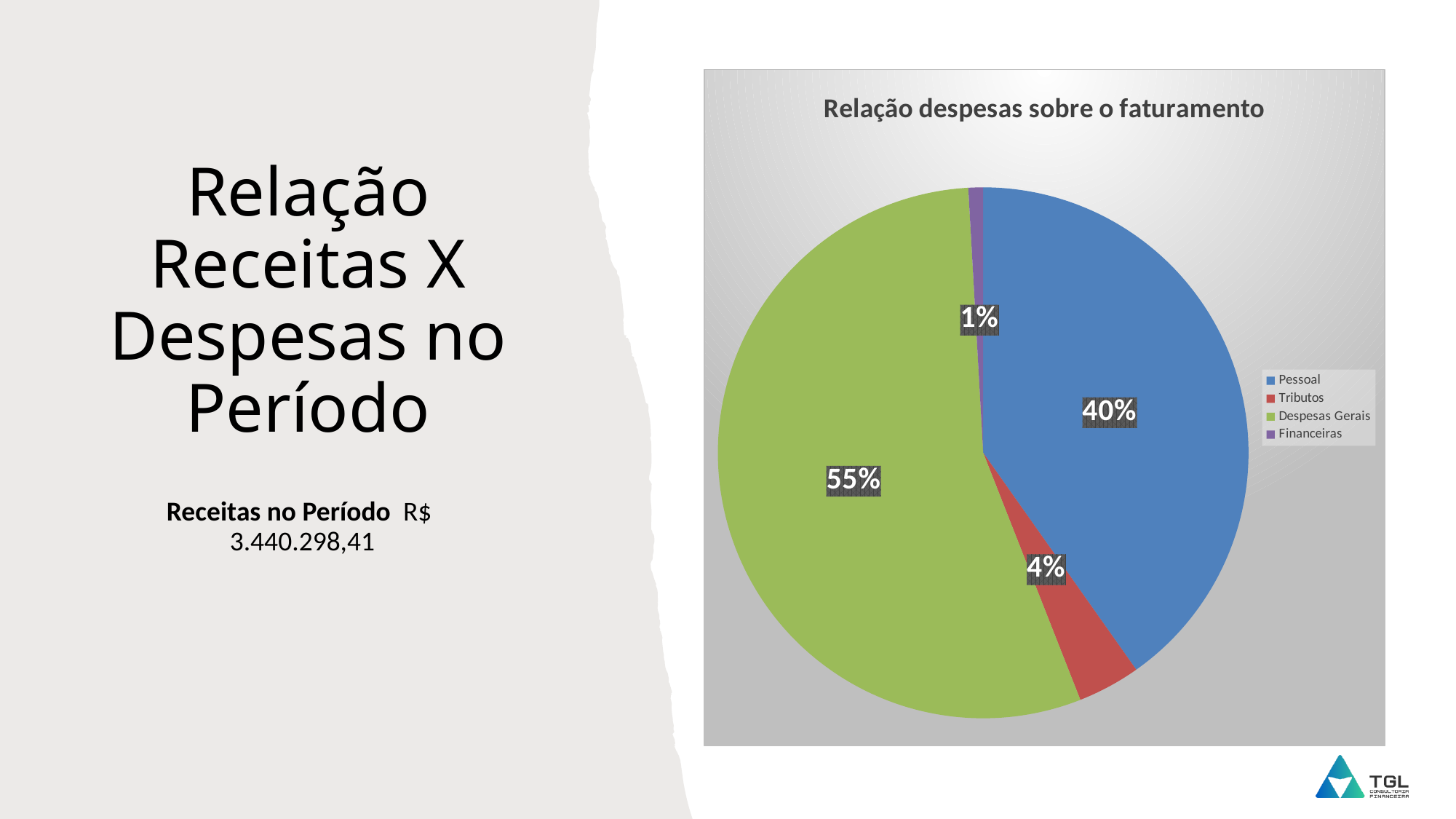
What share of the pie does Financeiras represent? 1% Which category has the largest slice of the pie? Despesas Gerais What is the difference in percentage points between Despesas Gerais and Pessoal? 15 How many categories does the legend list? 4 What type of chart is shown on the slide? pie chart Which category has the smallest slice of the pie? Financeiras What is the title of the chart? Relação despesas sobre o faturamento What share of the pie does Despesas Gerais represent? 55% Which is larger, the slice for Tributos or the slice for Financeiras? Tributos What share of the pie does Tributos represent? 4% What colour is the slice for Pessoal? blue